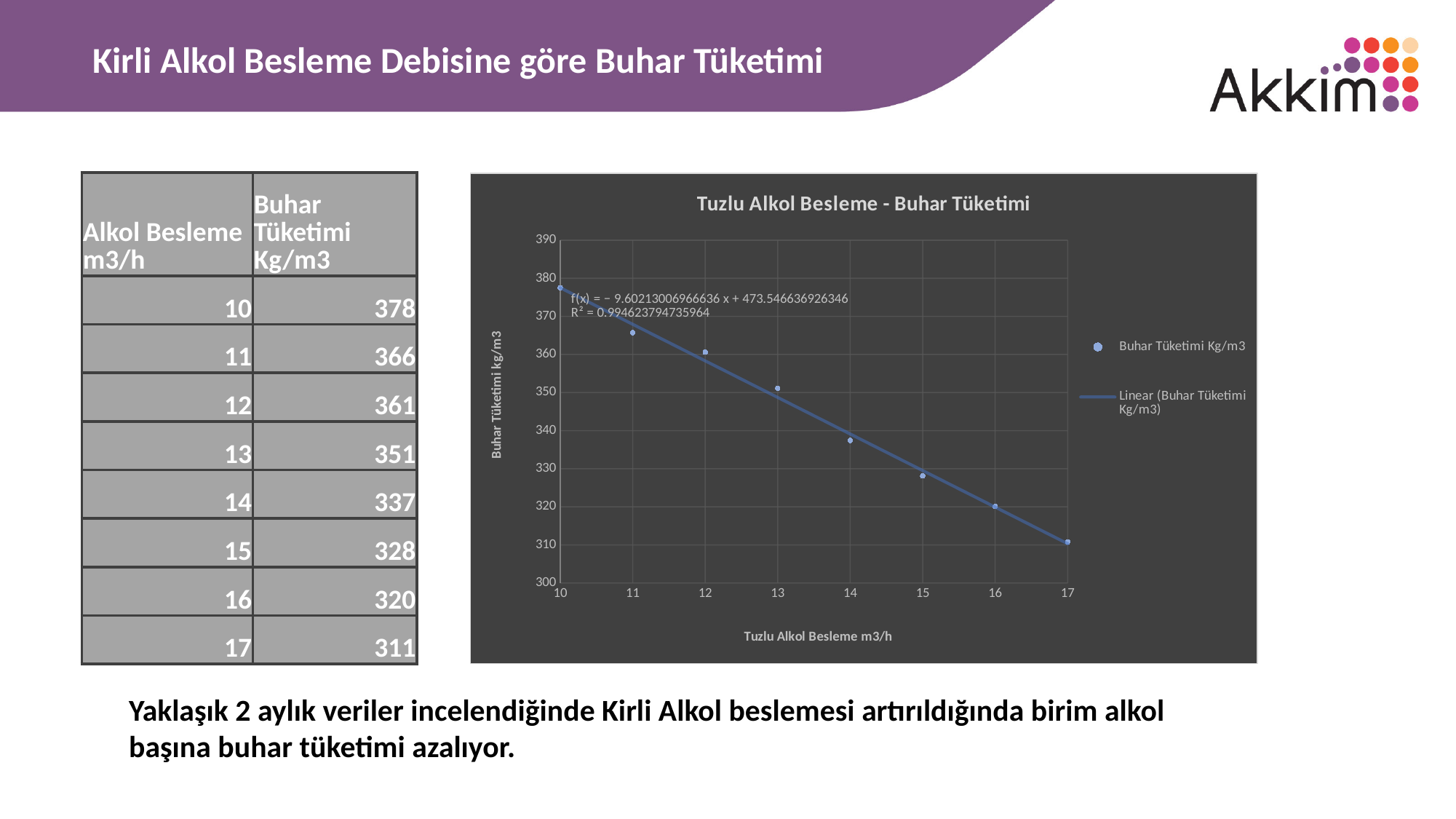
Is the Buhar Tüketimi value at 11 m3/h greater or less than 370? less What is the Buhar Tüketimi value at an Alkol Besleme of 10 m3/h? 378 At which Alkol Besleme value is Buhar Tüketimi highest? 10 How many entries does the chart legend list? 2 Do the Buhar Tüketimi values rise or fall as Tuzlu Alkol Besleme increases along the x axis? fall What kind of chart is shown on the slide? scatter chart What is the title of the chart? Tuzlu Alkol Besleme - Buhar Tüketimi At which Alkol Besleme value is Buhar Tüketimi lowest? 17 What is the Buhar Tüketimi value at an Alkol Besleme of 17 m3/h? 311 How many data points are plotted in the chart? 8 Which has the larger Buhar Tüketimi value, 12 m3/h or 15 m3/h? 12 m3/h What is the difference between the Buhar Tüketimi values at 10 m3/h and 17 m3/h? 67